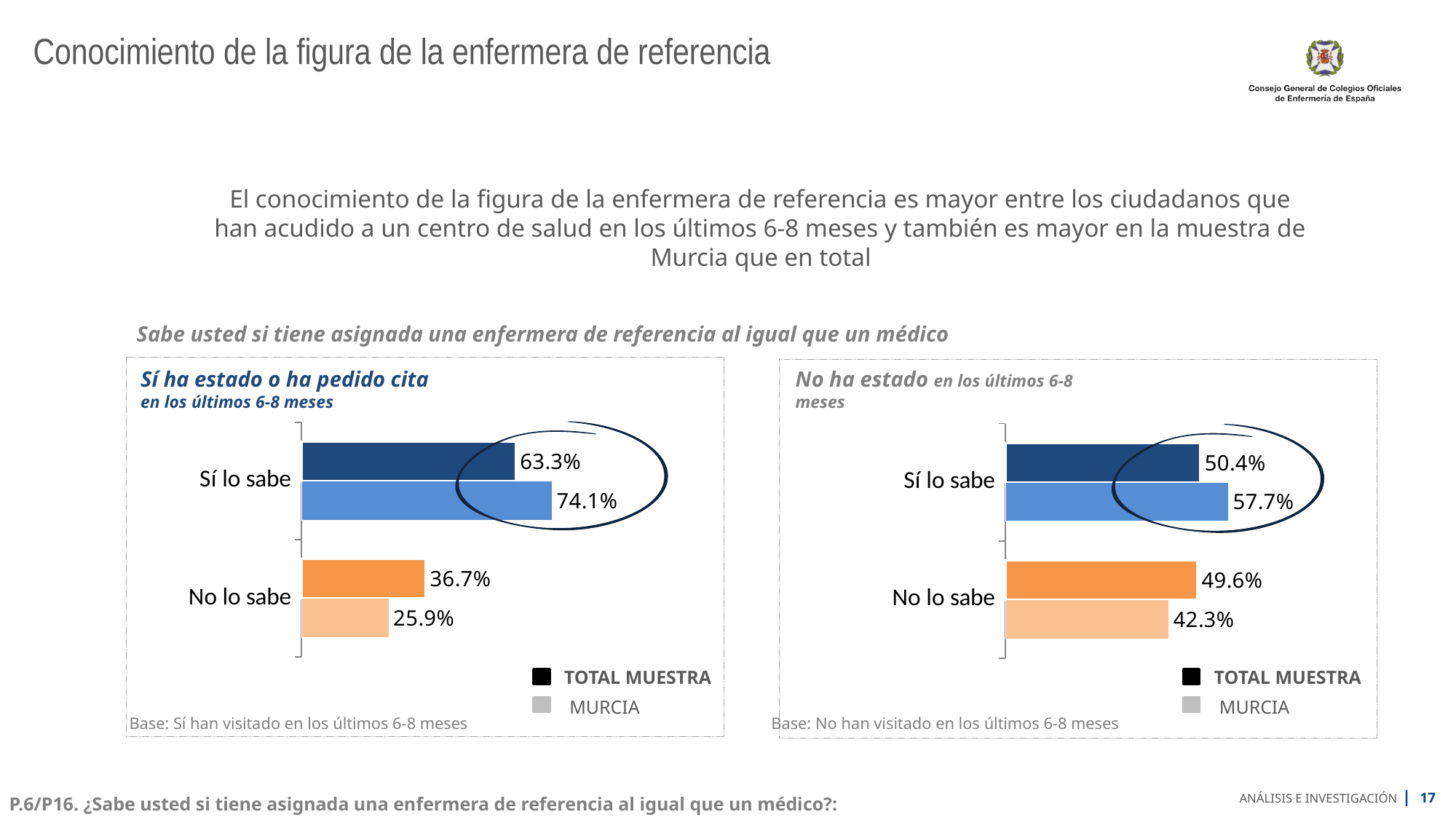
In the chart titled 'No ha estado en los últimos 6-8 meses', what is the difference between the TOTAL MUESTRA and MURCIA values for 'No lo sabe'? 7.3% In the chart titled 'Sí ha estado o ha pedido cita en los últimos 6-8 meses', which is larger for 'No lo sabe': TOTAL MUESTRA or MURCIA? TOTAL MUESTRA In the chart titled 'Sí ha estado o ha pedido cita en los últimos 6-8 meses', what is the value for 'Sí lo sabe' for the MURCIA series? 74.1% How many series does the legend list in the chart titled 'No ha estado en los últimos 6-8 meses'? 2 In the chart titled 'Sí ha estado o ha pedido cita en los últimos 6-8 meses', which bar has the lowest value? No lo sabe, MURCIA (25.9%) In the chart titled 'No ha estado en los últimos 6-8 meses', what is the value for 'No lo sabe' for the TOTAL MUESTRA series? 49.6% What type of chart is the chart titled 'No ha estado en los últimos 6-8 meses'? Bar chart How many categories are shown in the chart titled 'Sí ha estado o ha pedido cita en los últimos 6-8 meses'? 2 In the chart titled 'No ha estado en los últimos 6-8 meses', which series has the highest value for 'Sí lo sabe'? MURCIA In the chart titled 'Sí ha estado o ha pedido cita en los últimos 6-8 meses', what is the difference between the MURCIA and TOTAL MUESTRA values for 'Sí lo sabe'? 10.8% In the chart titled 'No ha estado en los últimos 6-8 meses', what is the value for 'Sí lo sabe' for the MURCIA series? 57.7% In the chart titled 'Sí ha estado o ha pedido cita en los últimos 6-8 meses', what is the value for 'Sí lo sabe' for the TOTAL MUESTRA series? 63.3%